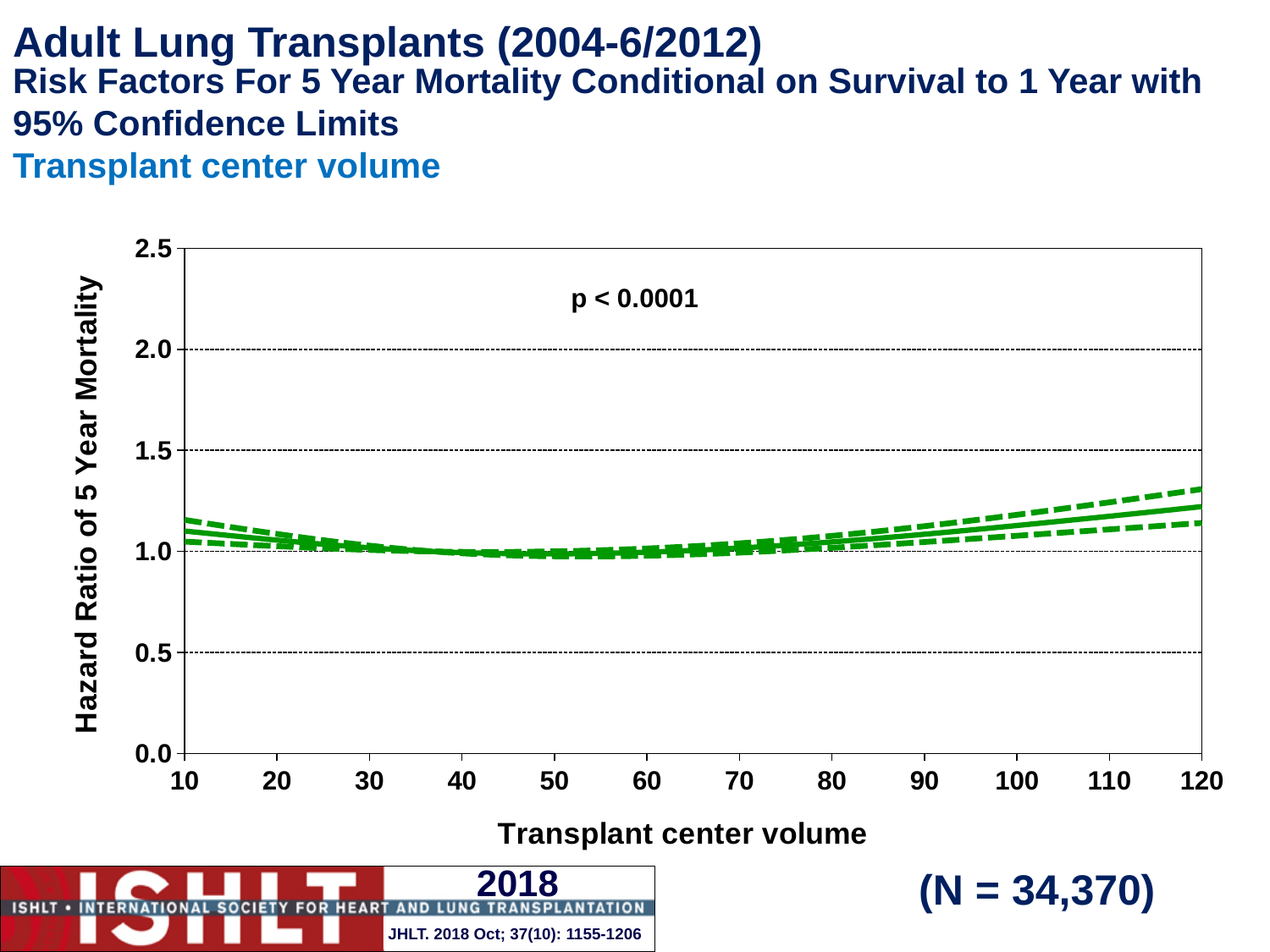
How many tick labels are shown on the x axis? 12 Is the hazard ratio at a transplant center volume of 50 greater or less than 1.5? less Which transplant center volume has the higher hazard ratio, 50 or 120? 120 What sample size (N) is shown on the slide? N = 34,370 What p-value is printed on the chart? p < 0.0001 Does the hazard ratio rise or fall as transplant center volume increases from 60 to 120? rises Which transplant center volume has the higher hazard ratio, 10 or 50? 10 Is the hazard ratio at a transplant center volume of 10 greater or less than 2.0? less Is the hazard ratio at a transplant center volume of 120 greater or less than 1.5? less Does the hazard ratio rise or fall as transplant center volume increases from 10 to 40? falls What kind of chart is shown on the slide? line chart